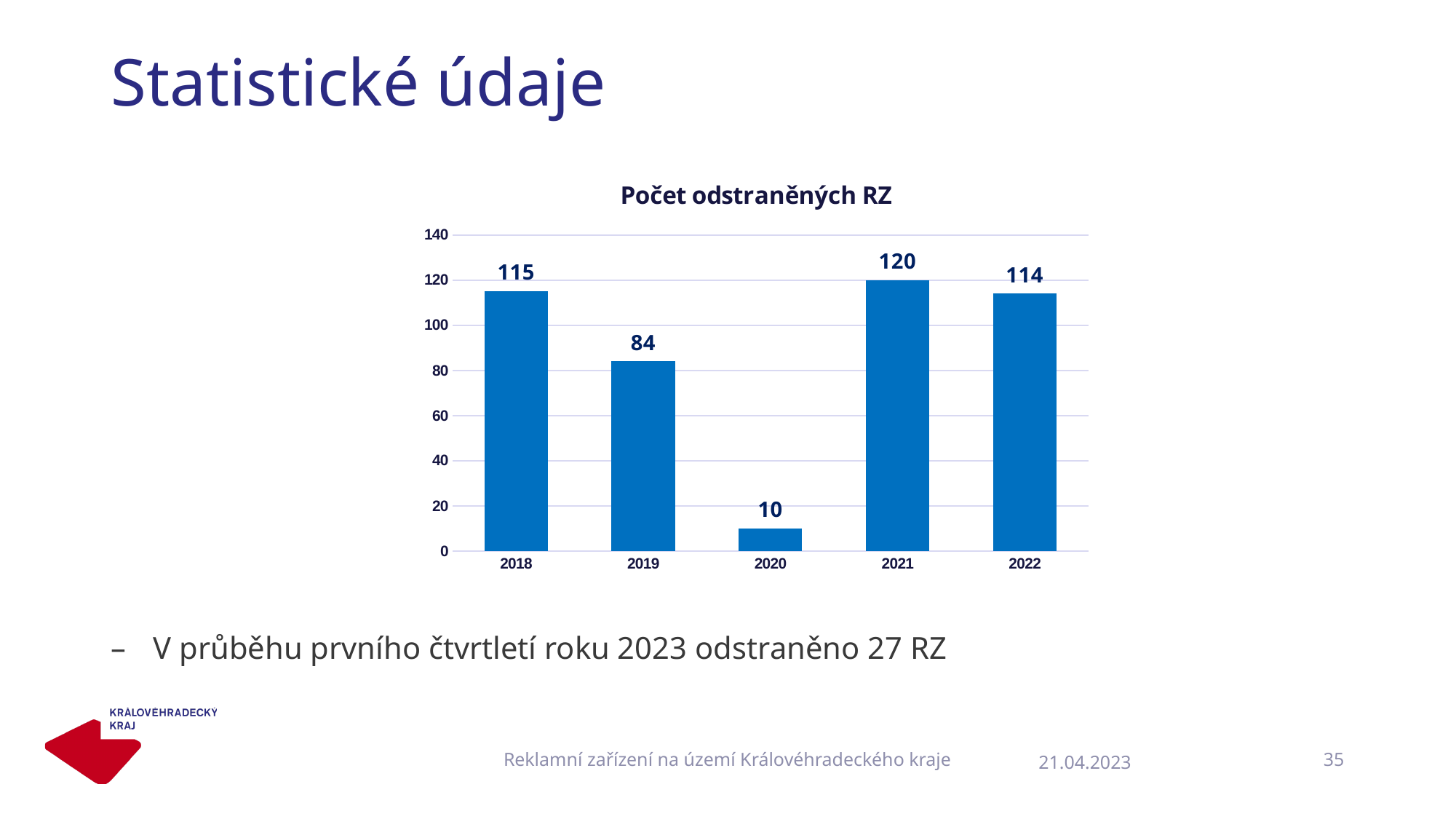
What kind of chart is shown? bar chart Is the value for 2019 greater or less than 100? less What is the value for 2018? 115 What is the value for 2020? 10 What is the difference between the values for 2021 and 2019? 36 Which year has the highest value? 2021 Which year has the lowest value? 2020 Which is larger, the value for 2018 or the value for 2022? 2018 What is the title of the chart? Počet odstraněných RZ Do the values rise or fall from 2019 to 2020? fall How many years are shown on the x axis? 5 What is the value for 2022? 114